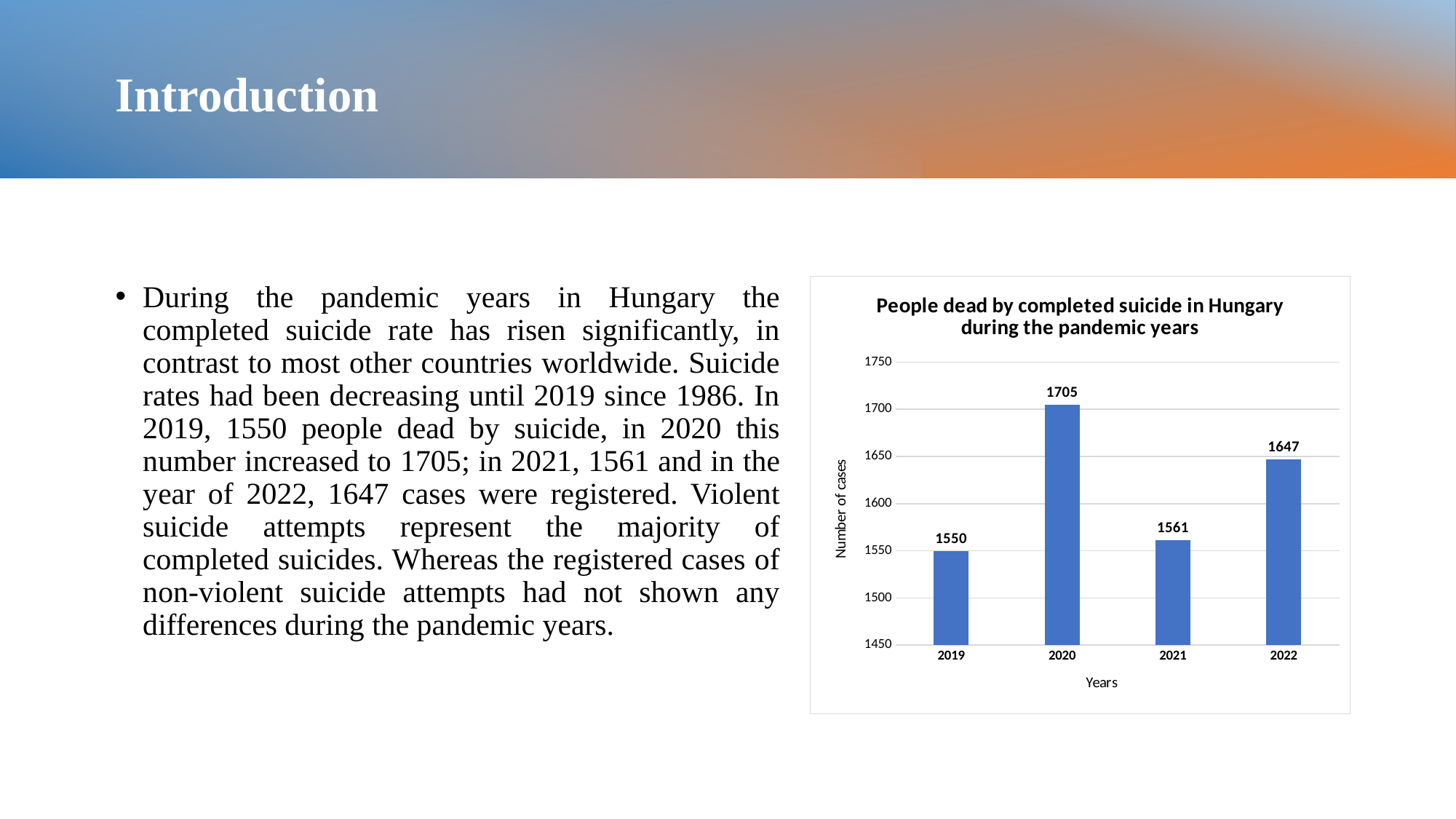
What is the number of cases for 2020? 1705 What is the title of the chart? People dead by completed suicide in Hungary during the pandemic years Which year has more cases, 2021 or 2022? 2022 What is the difference between the number of cases in 2022 and 2021? 86 What kind of chart is shown on the slide? Bar chart Which year has the highest number of cases? 2020 What is the number of cases for 2022? 1647 Is the value for 2021 greater or less than 1600? less Which year has the lowest number of cases? 2019 What is the difference between the number of cases in 2020 and 2019? 155 What is the number of cases for 2019? 1550 How many years are shown on the x axis? 4